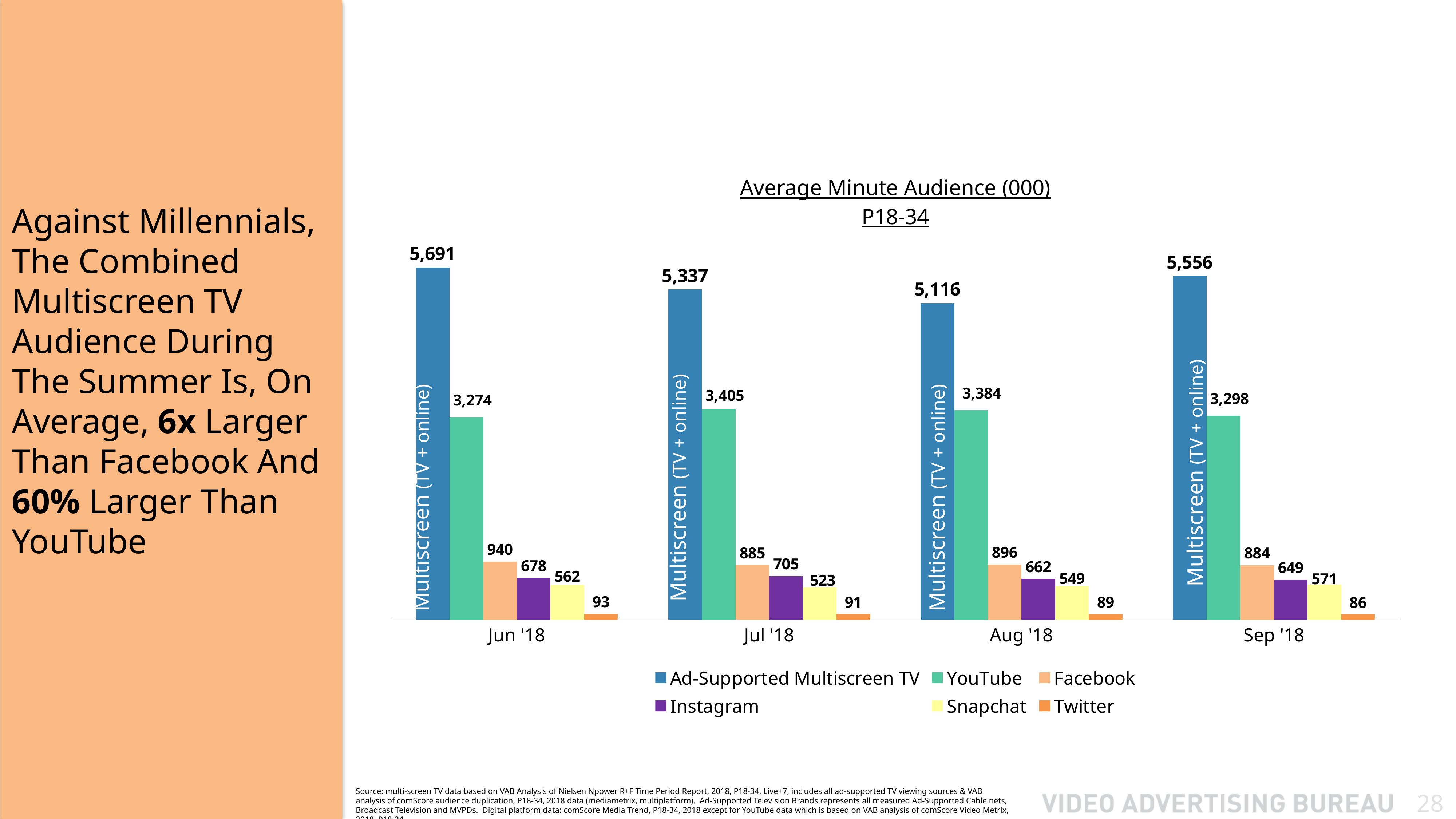
What kind of chart is shown on the slide? Bar chart What is the difference between the Ad-Supported Multiscreen TV value and the YouTube value in Sep '18? 2,258 How many series does the legend list? 6 What is the YouTube value for Jul '18? 3,405 How many months are shown on the x axis? 4 In which month is the Ad-Supported Multiscreen TV value lowest? Aug '18 What is the Facebook value for Aug '18? 896 Which is larger in Jun '18, the Instagram value or the Snapchat value? Instagram What is the title of the chart? Average Minute Audience (000) P18-34 What is the Ad-Supported Multiscreen TV value for Jun '18? 5,691 In which month is the YouTube value highest? Jul '18 What is the Twitter value for Sep '18? 86